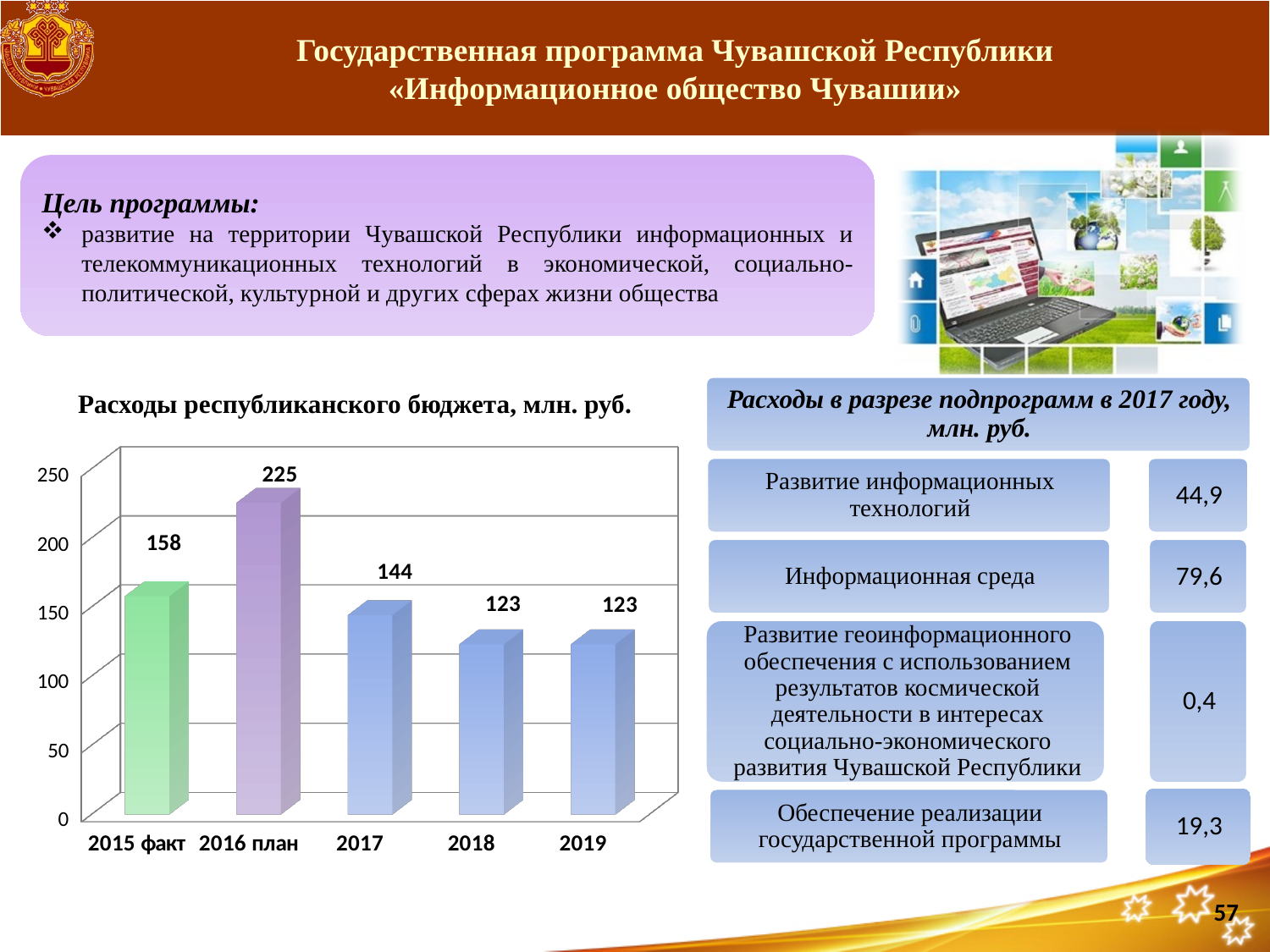
What is the lowest value shown in the chart? 123 What kind of chart is shown on the slide? bar chart What is the value for 2015 факт in the chart? 158 What is the difference between the values for 2016 план and 2015 факт? 67 What is the value for 2016 план in the chart 'Расходы республиканского бюджета, млн. руб.'? 225 What is the difference between the values for 2017 and 2018? 21 What is the title of the chart on the slide? Расходы республиканского бюджета, млн. руб. Which is larger, the value for 2015 факт or the value for 2017? 2015 факт Is the value for 2016 план greater or less than 200? greater Which category has the highest value in the chart? 2016 план How many categories are shown on the x axis of the chart? 5 What is the value for 2017 in the chart? 144